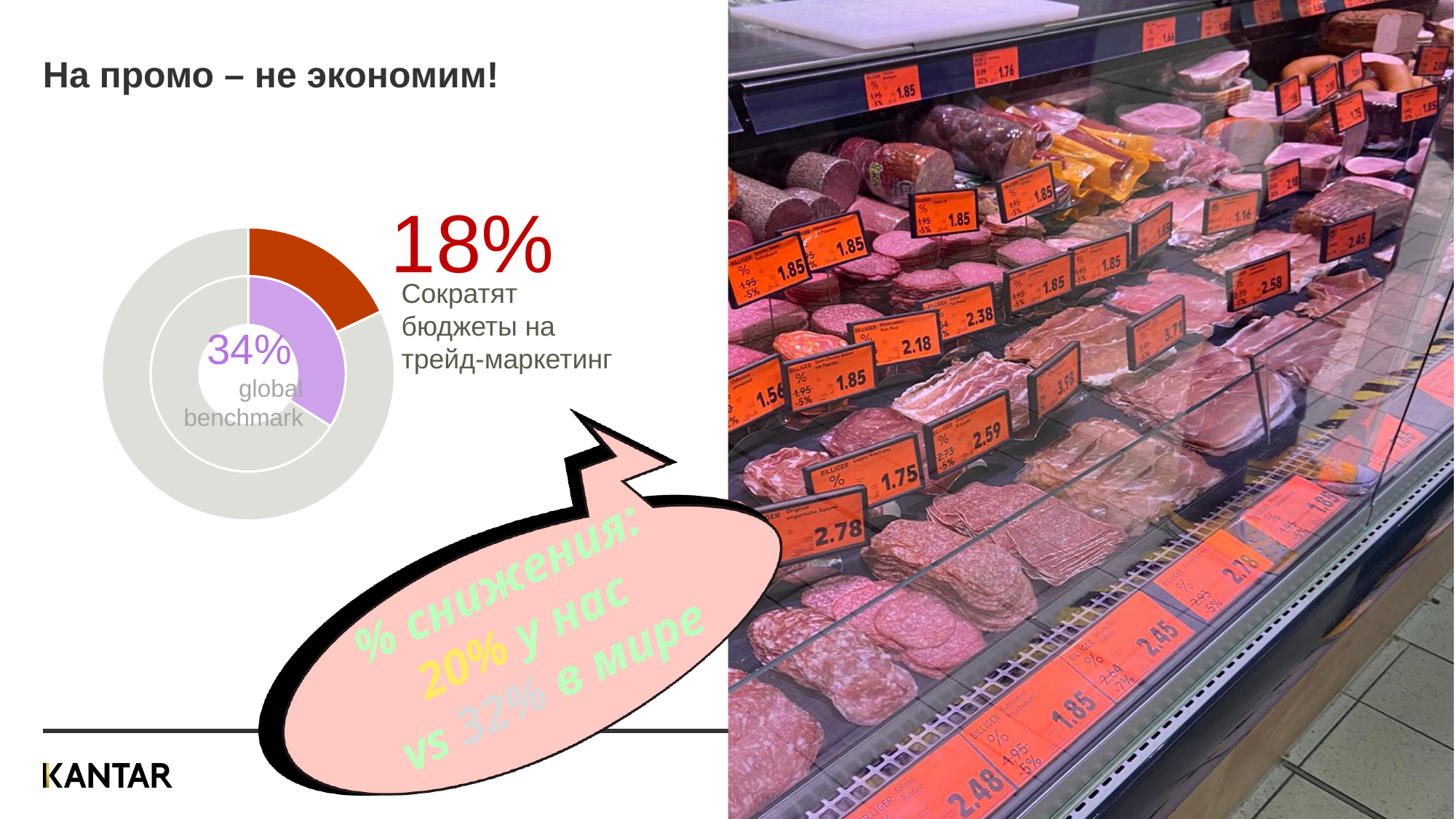
By how many percentage points does the global benchmark exceed the 18% value shown on the chart? 16 percentage points What value is shown for the global benchmark in the inner ring of the donut chart? 34% What is the title of the slide containing the donut chart? На промо – не экономим! Which is larger: the 18% value on the outer ring or the global benchmark on the inner ring? Global benchmark (34%) Is the global benchmark value on the chart greater or less than 30%? greater What colour is the 18% segment on the outer ring of the donut chart? Dark red / orange-brown What percentage is shown on the outer ring of the donut chart? 18% How many rings does the donut chart have? 2 What kind of chart is shown on the slide? Donut (pie) chart Is the 18% value on the outer ring greater or less than 25%? less What share of respondents will cut trade-marketing budgets (Сократят бюджеты на трейд-маркетинг) according to the chart? 18%